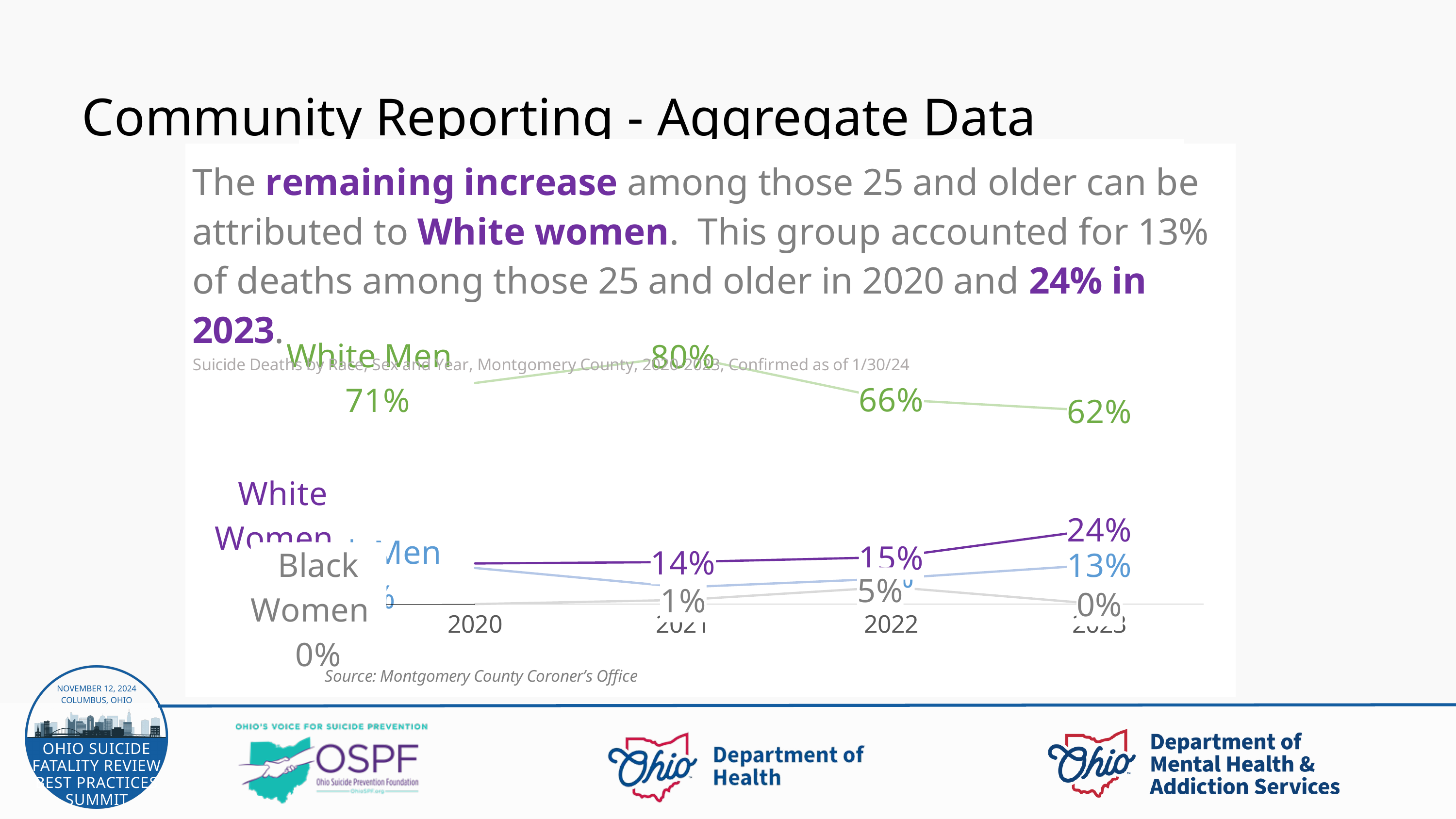
What is the value for White Women in 2021? 14% In 2023, which is larger: the value for White Women or the value for Black Men? White Women How many years are shown on the x axis? 4 In which year is the White Men series highest? 2021 What is the value for White Men in 2021? 80% What is the value for White Women in 2023? 24% In which year is the White Men series lowest? 2023 What kind of chart is shown on the slide? Line chart What is the value for Black Men in 2023? 13% What is the difference between the White Men values in 2021 and 2023? 18 percentage points Does the White Women series rise or fall from 2021 to 2023? Rise What is the value for White Men in 2023? 62%